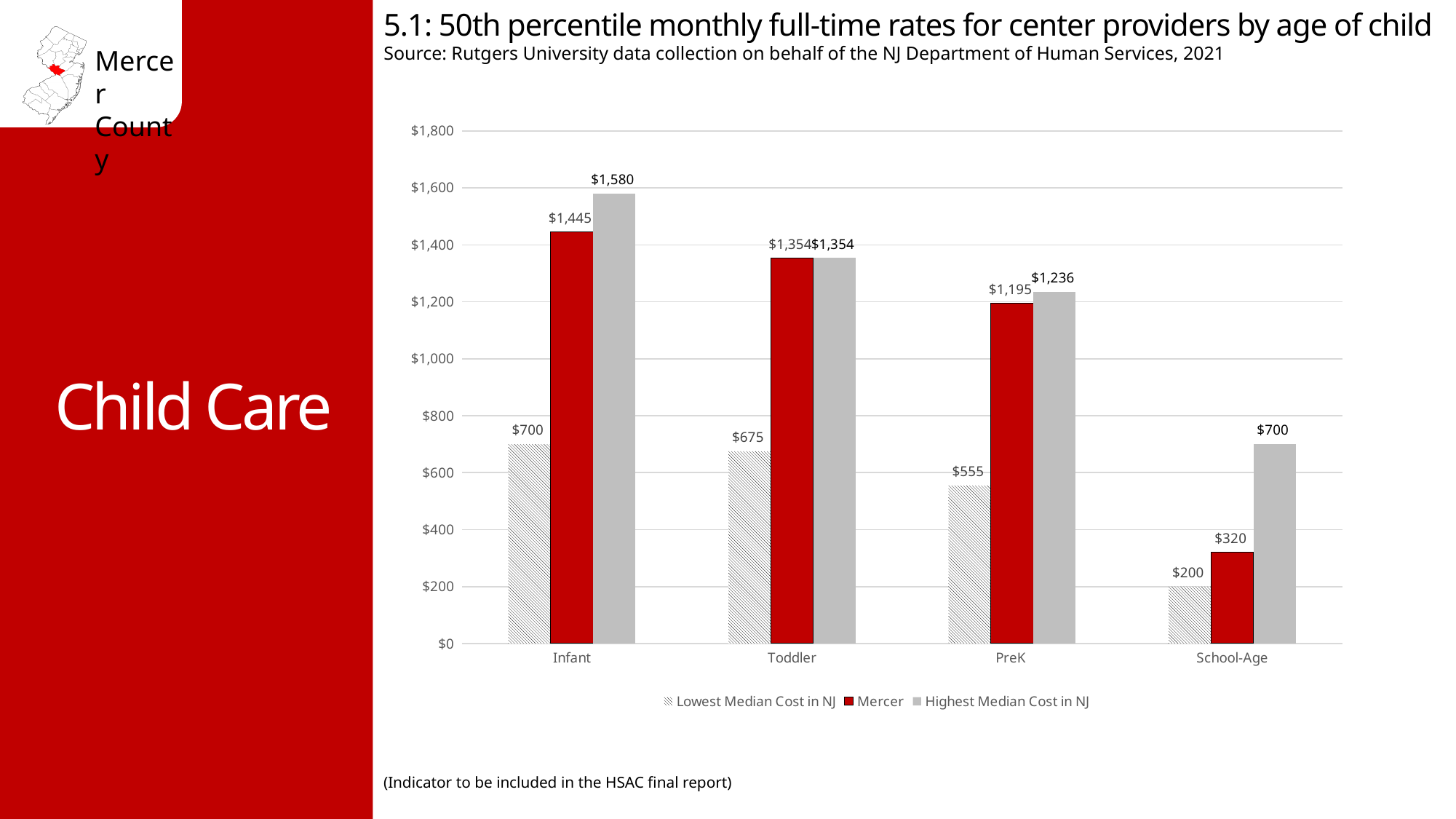
Which is larger for PreK: the Mercer value or the Highest Median Cost in NJ? Highest Median Cost in NJ Which age group has the highest Mercer value? Infant How many series does the legend list? 3 What is the difference between the Highest Median Cost in NJ and the Mercer value for Infant? $135 What is the Lowest Median Cost in NJ for PreK? $555 Do the Mercer values rise or fall from Toddler to School-Age? Fall What is the difference between the Mercer value and the Lowest Median Cost in NJ for School-Age? $120 What is the Mercer value for Infant? $1,445 What kind of chart is shown on the slide? Bar chart Which age group has the lowest Lowest Median Cost in NJ? School-Age What is the Highest Median Cost in NJ for School-Age? $700 How many age groups are shown on the x axis? 4